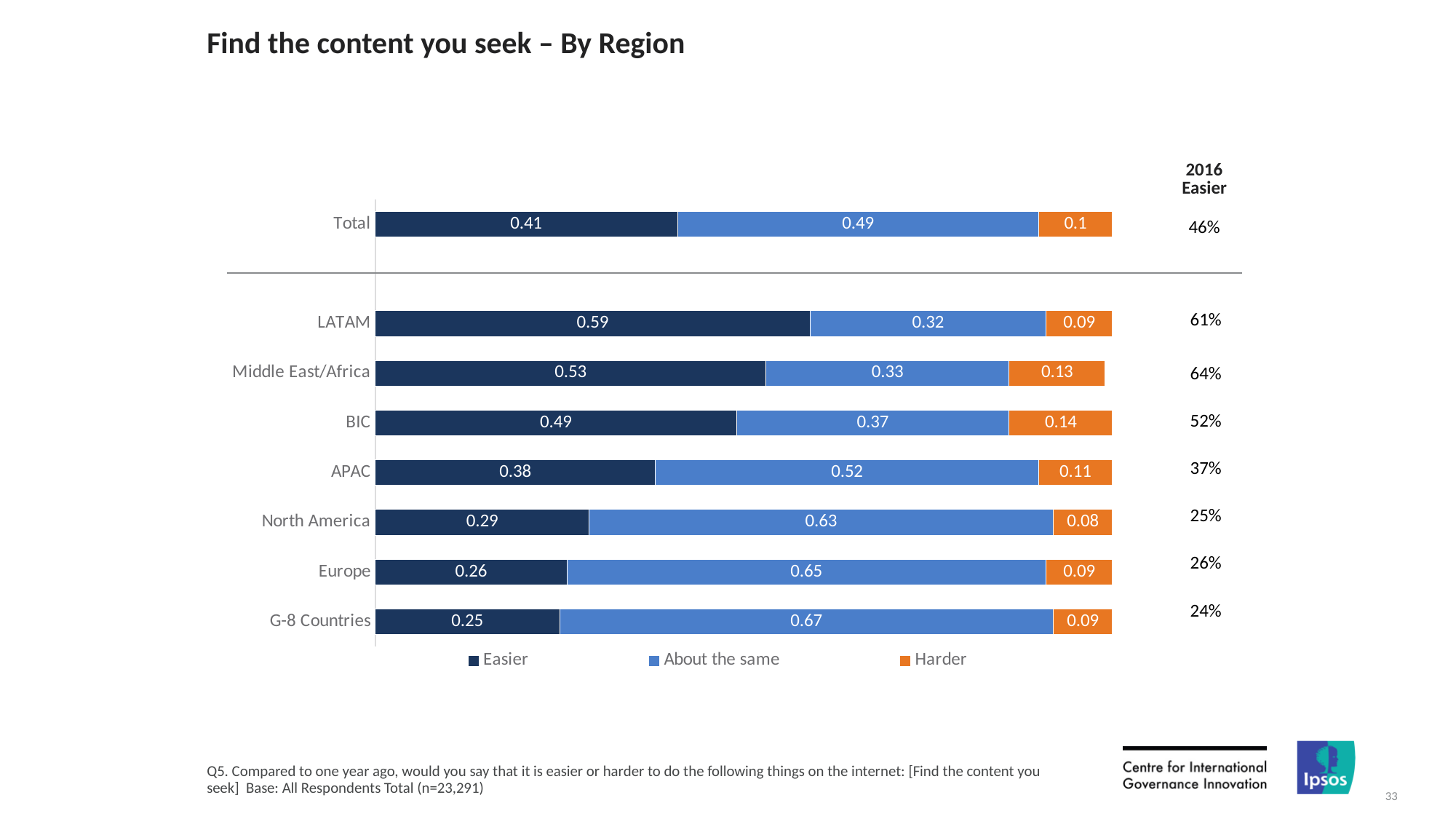
Which is larger, the 'About the same' value for APAC or for BIC? APAC How many series does the legend list? 3 What is the 'Harder' value for Total? 0.1 What kind of chart is shown on the slide? Stacked bar chart What is the 'Harder' value for BIC? 0.14 How many regions are shown below the Total bar? 7 Which region has the lowest 'Easier' value? G-8 Countries What is the 'About the same' value for North America? 0.63 What is the difference between the 'Easier' values for LATAM and Europe? 0.33 What is the 2016 Easier percentage shown for Middle East/Africa? 64% Which region has the highest 'Easier' value? LATAM What is the 'Easier' value for LATAM? 0.59